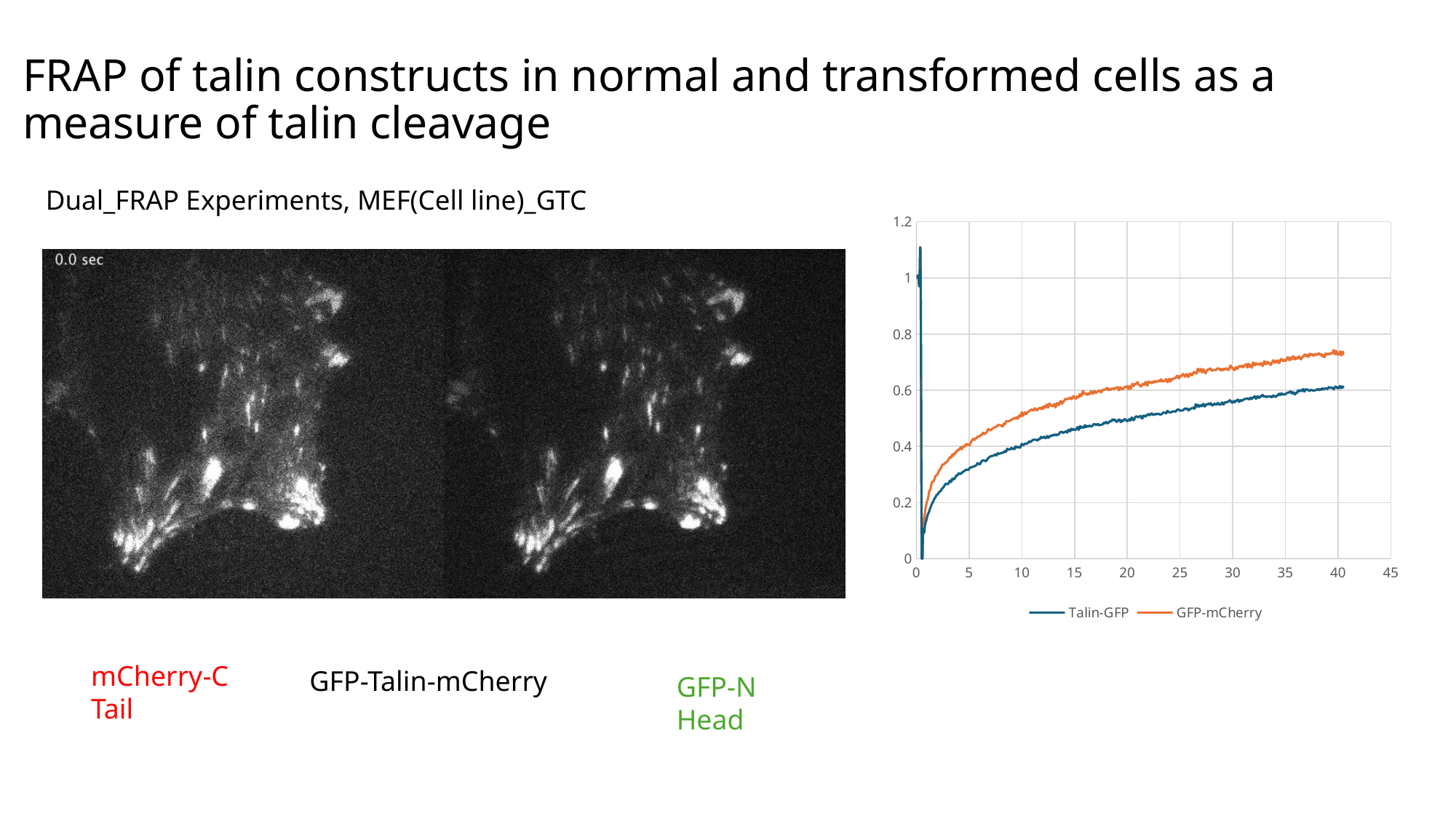
In the line chart, do the values of the Talin-GFP series rise or fall along the x axis after the initial drop? rise In the line chart, do the values of the GFP-mCherry series rise or fall along the x axis after the initial drop? rise What kind of chart is shown on the right of the slide? line chart In the line chart, is the value of Talin-GFP at x = 5 greater or less than 0.4? less What is the highest tick value shown on the x axis of the line chart? 45 In the line chart, which series has the higher value at x = 40, Talin-GFP or GFP-mCherry? GFP-mCherry How many series does the legend of the line chart list? 2 Which series in the line chart is drawn in orange? GFP-mCherry In the line chart, is the value of GFP-mCherry at x = 40 greater or less than 0.6? greater What are the two series named in the legend of the line chart? Talin-GFP and GFP-mCherry In the line chart, is the value of GFP-mCherry at x = 30 greater or less than 0.6? greater